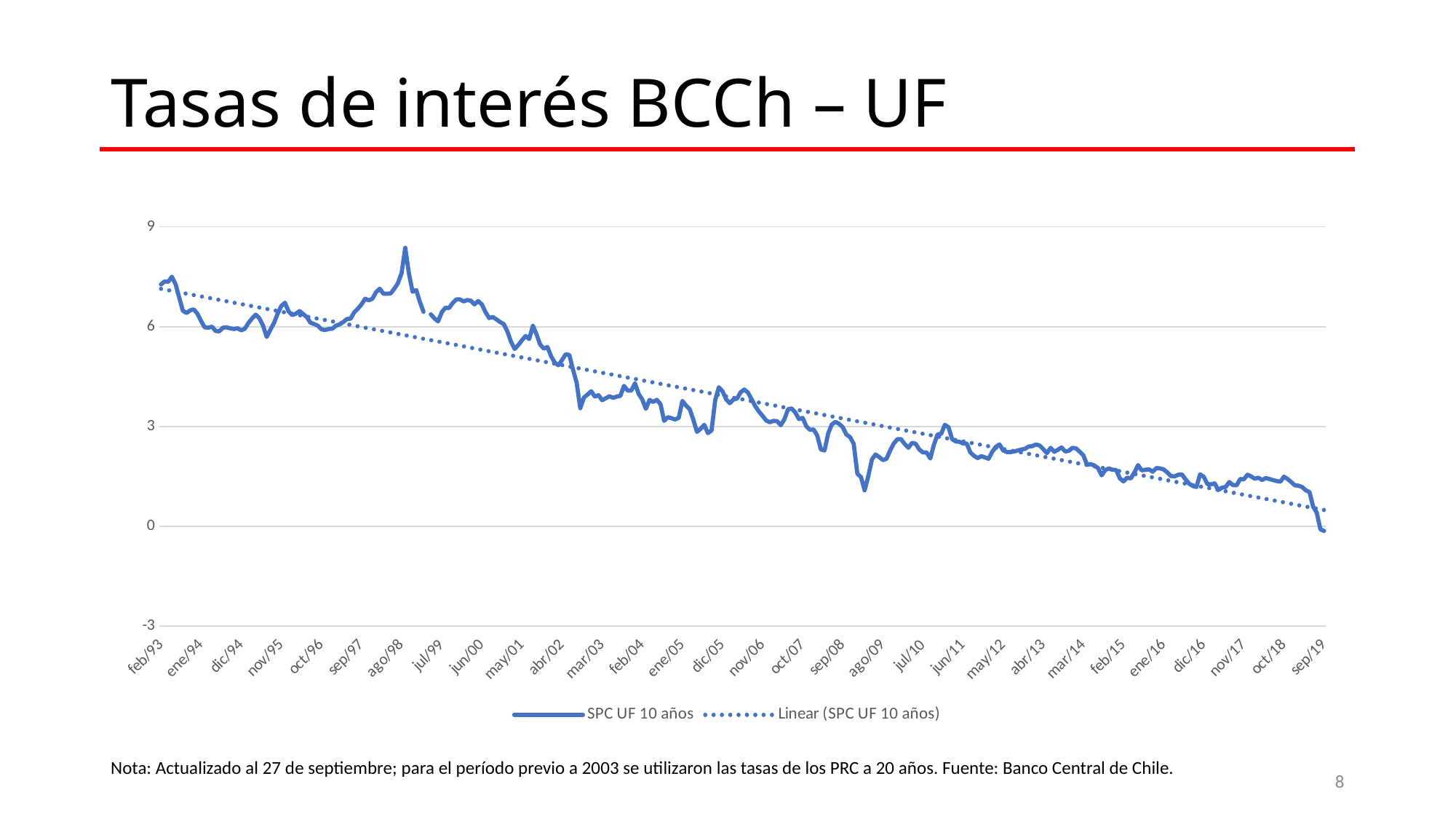
Is the value of SPC UF 10 años at feb/93 greater or less than 6? greater Near which x-axis label does the SPC UF 10 años series reach its highest value? ago/98 What are the two entries in the chart legend? SPC UF 10 años; Linear (SPC UF 10 años) What kind of chart is shown on the slide? line chart At which x-axis label does the SPC UF 10 años series reach its lowest value? sep/19 Is the value of SPC UF 10 años at sep/19 greater or less than 3? less How many series does the legend list? 2 What is the title of the slide's chart? Tasas de interés BCCh – UF Does the SPC UF 10 años series generally rise or fall from feb/93 to sep/19? fall Which is larger, the SPC UF 10 años value at feb/93 or at sep/19? feb/93 Is the peak of SPC UF 10 años near ago/98 greater or less than 6? greater